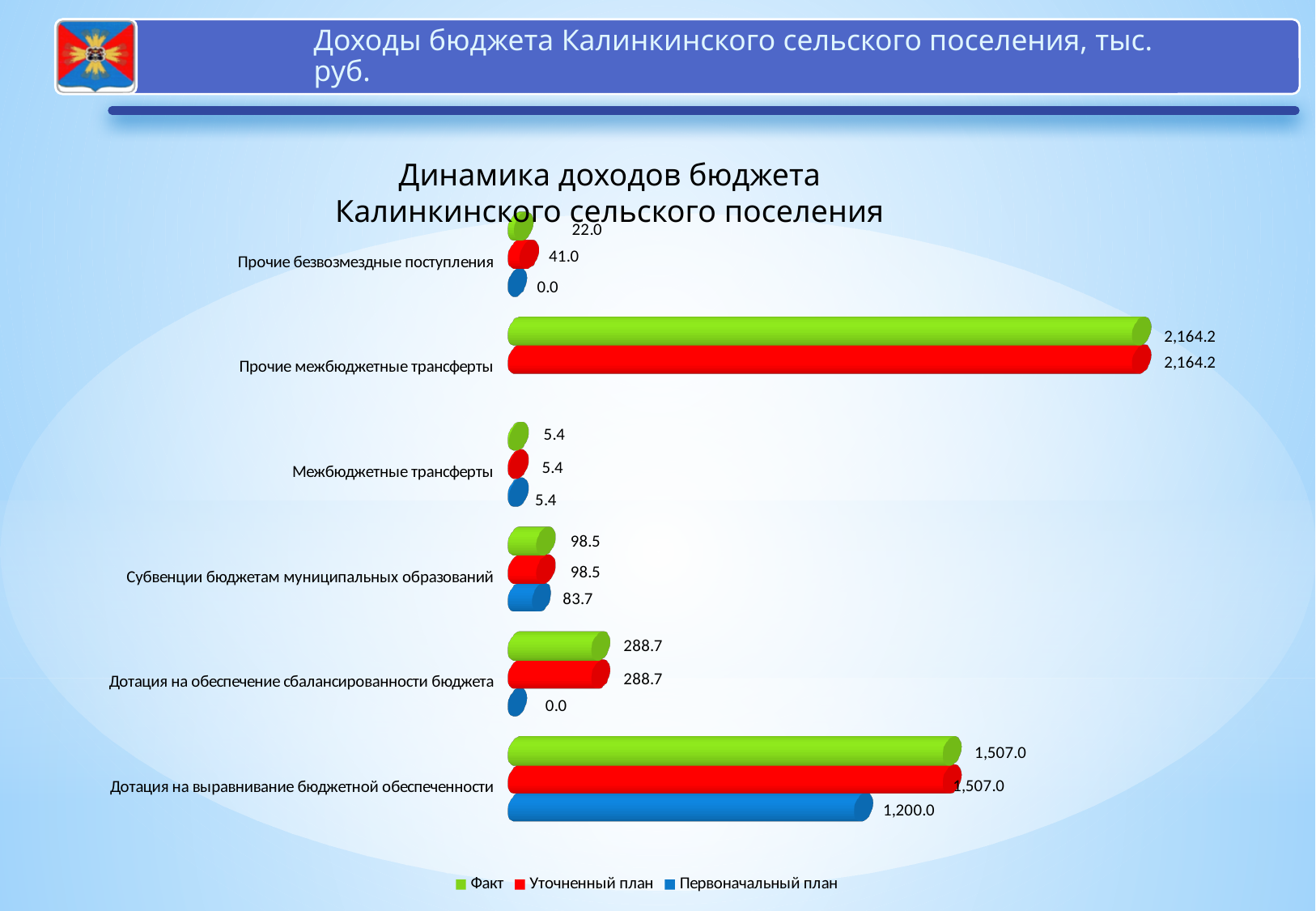
What is the Факт value for Прочие межбюджетные трансферты? 2,164.2 What is the Первоначальный план value for Дотация на выравнивание бюджетной обеспеченности? 1,200.0 What is the Уточненный план value for Прочие безвозмездные поступления? 41.0 Which series is shown in green in the chart? Факт Which is larger for Прочие безвозмездные поступления: the Факт value or the Уточненный план value? Уточненный план Which category has the lowest Факт value? Межбюджетные трансферты Which category has the highest Факт value? Прочие межбюджетные трансферты What is the difference between the Уточненный план and Первоначальный план values for Дотация на выравнивание бюджетной обеспеченности? 307.0 What type of chart is shown on the slide? bar chart What is the Первоначальный план value for Субвенции бюджетам муниципальных образований? 83.7 How many categories are shown on the chart? 6 How many series does the chart legend list? 3